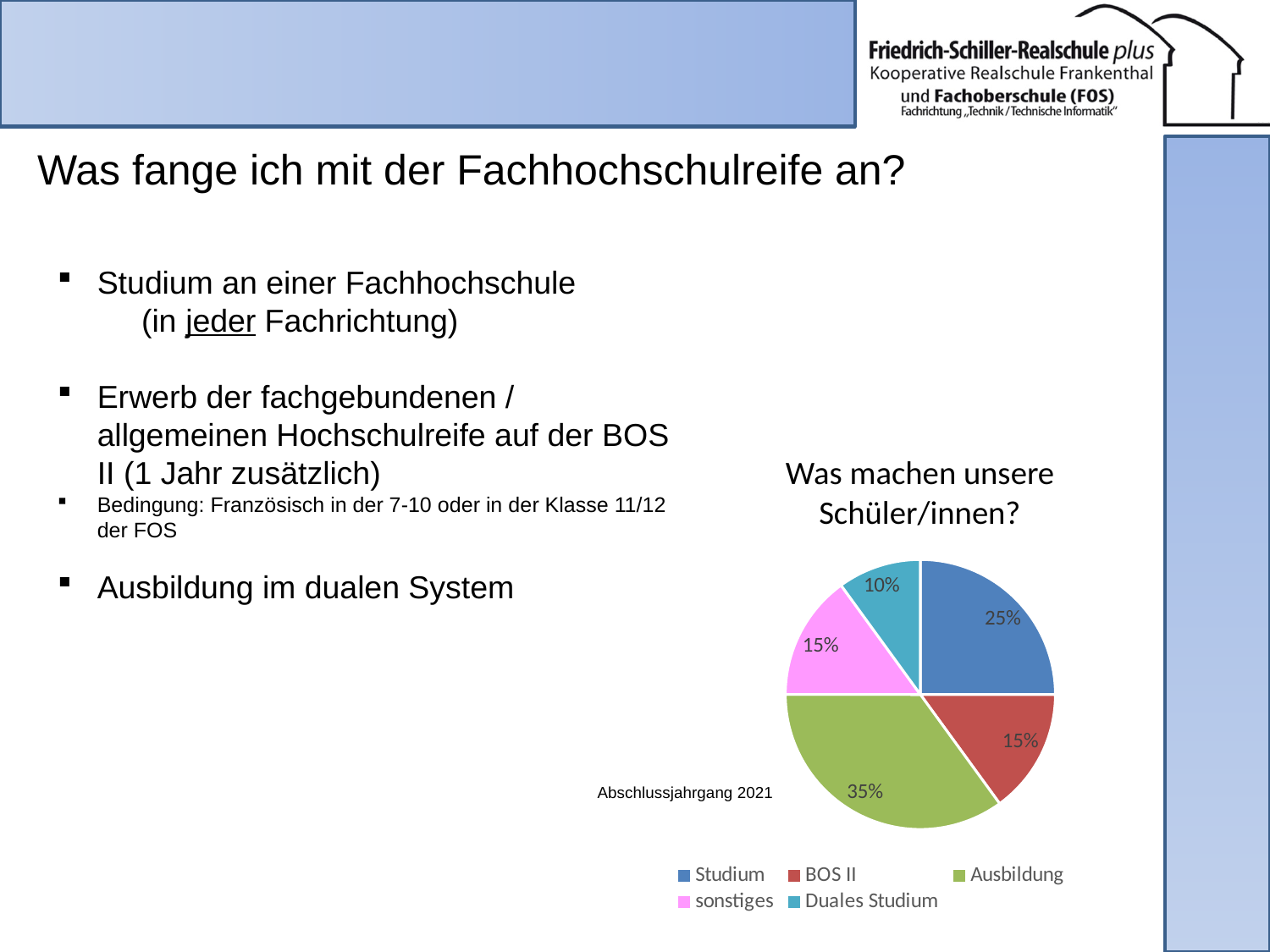
Which colour represents Ausbildung in the chart? green What share of the pie is Duales Studium? 10% What is the title of the chart? Was machen unsere Schüler/innen? Which category has the largest share of the pie? Ausbildung How many categories does the legend list? 5 What share of the pie is Ausbildung? 35% Which is larger, the share for Studium or the share for sonstiges? Studium What share of the pie is Studium? 25% What is the difference between the shares for Ausbildung and Studium? 10% What kind of chart is shown on the slide? pie chart Which category has the smallest share of the pie? Duales Studium